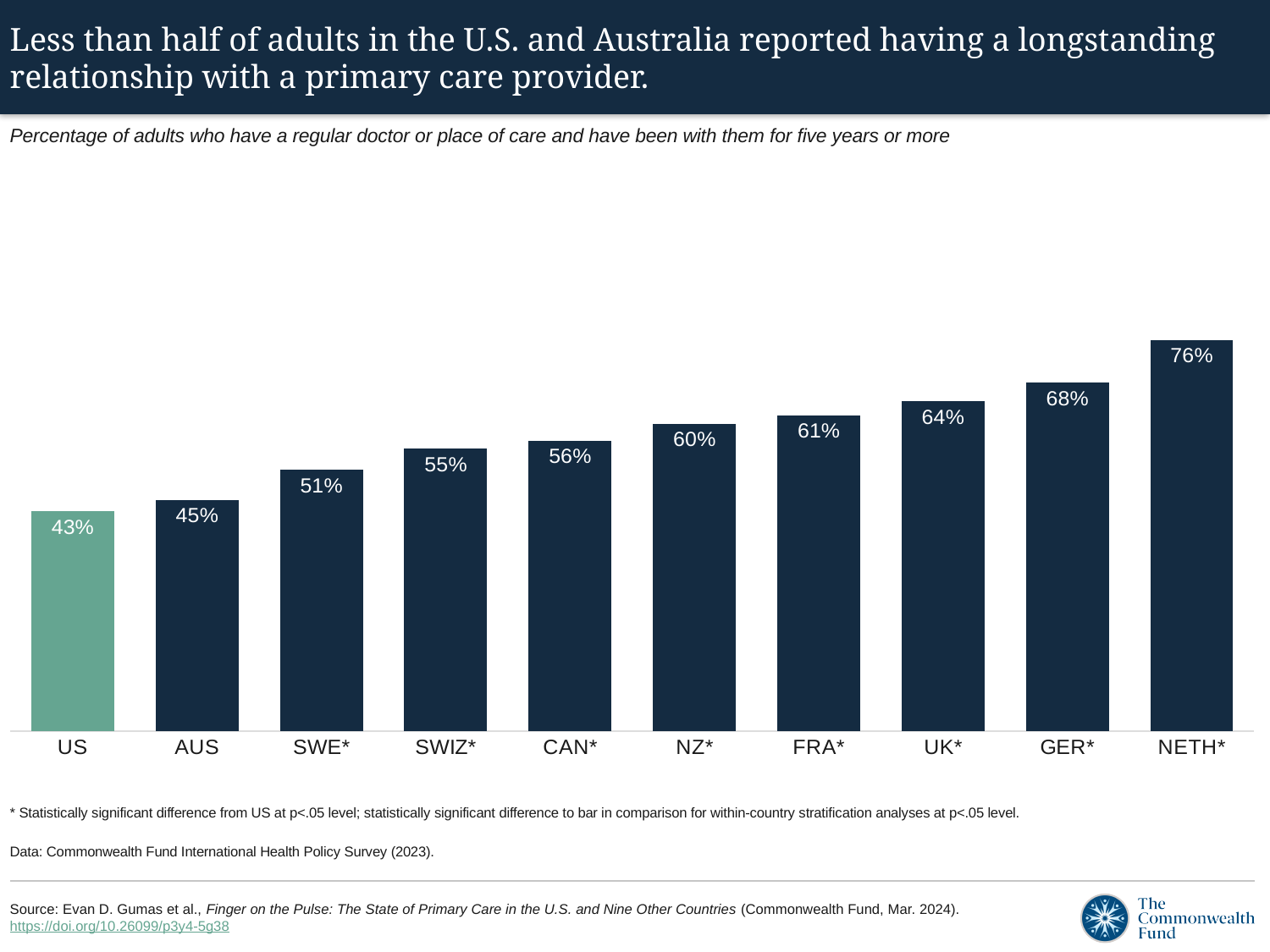
What is the value for the US? 43% What is the value for CAN*? 56% Which bar is shown in a different colour from the others? US What is the difference between the values for GER* and UK*? 4% What is the value for NETH*? 76% Which country has the highest value? NETH* What kind of chart is shown on the slide? Bar chart How many countries are shown in the chart? 10 Which country has the lowest value? US What is the difference between the values for NETH* and the US? 33% Do the values rise or fall from left to right across the chart? Rise Which is larger, the value for AUS or the value for SWE*? SWE*